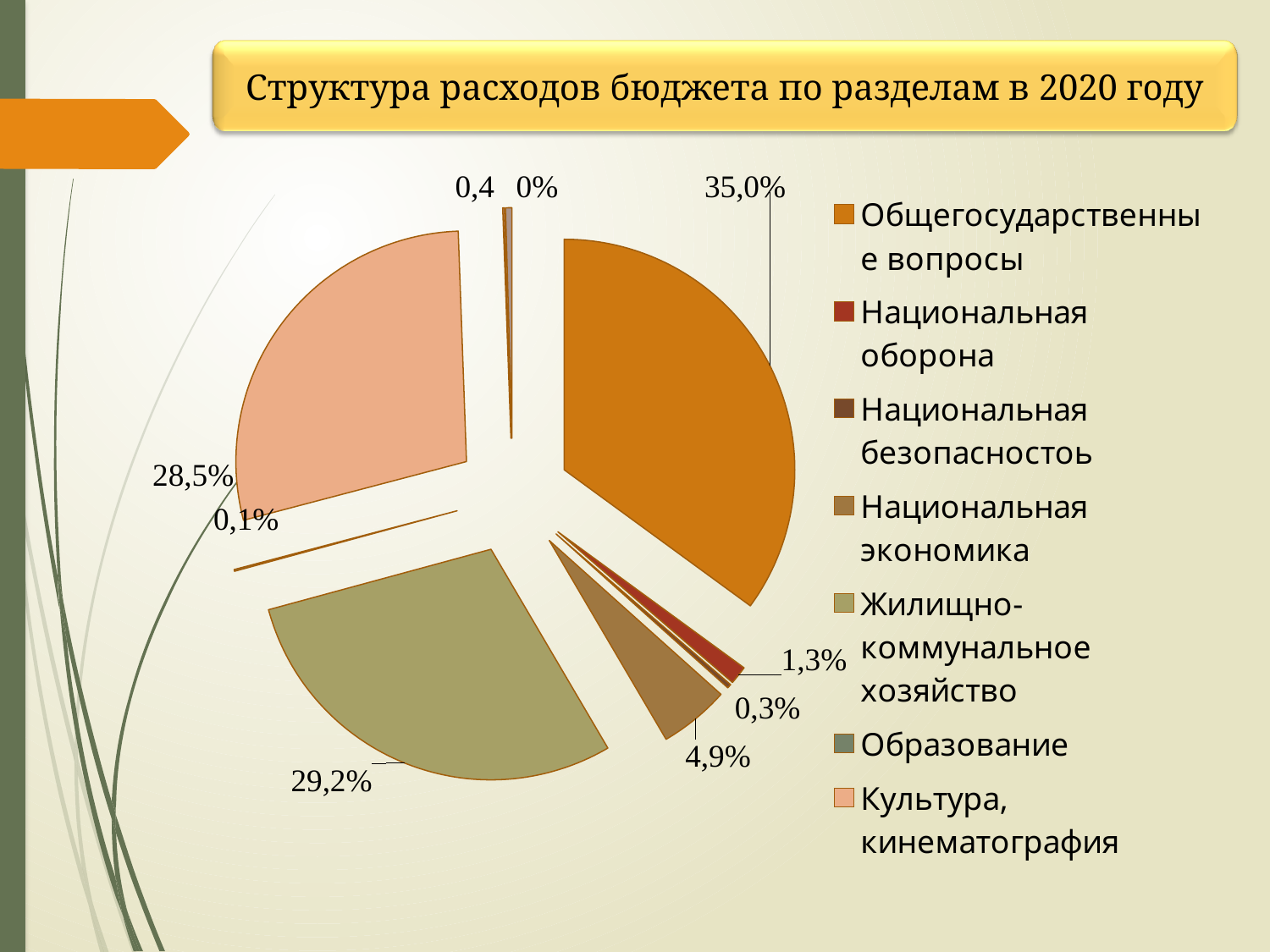
What share of the pie is labelled for Общегосударственные вопросы? 35,0% What is the title of the chart? Структура расходов бюджета по разделам в 2020 году What is the difference between the shares of Общегосударственные вопросы and Жилищно-коммунальное хозяйство? 5,8% What share of the pie is labelled for Национальная экономика? 4,9% What share of the pie is labelled for Национальная оборона? 1,3% What kind of chart is shown on the slide? pie chart Which section has the largest share of the budget expenditure? Общегосударственные вопросы How many entries does the legend list? 7 Which has the larger share: Жилищно-коммунальное хозяйство or Культура, кинематография? Жилищно-коммунальное хозяйство What share of the pie is labelled for Национальная безопасность? 0,3% What share of the pie is labelled for Жилищно-коммунальное хозяйство? 29,2% What share of the pie is labelled for Культура, кинематография? 28,5%